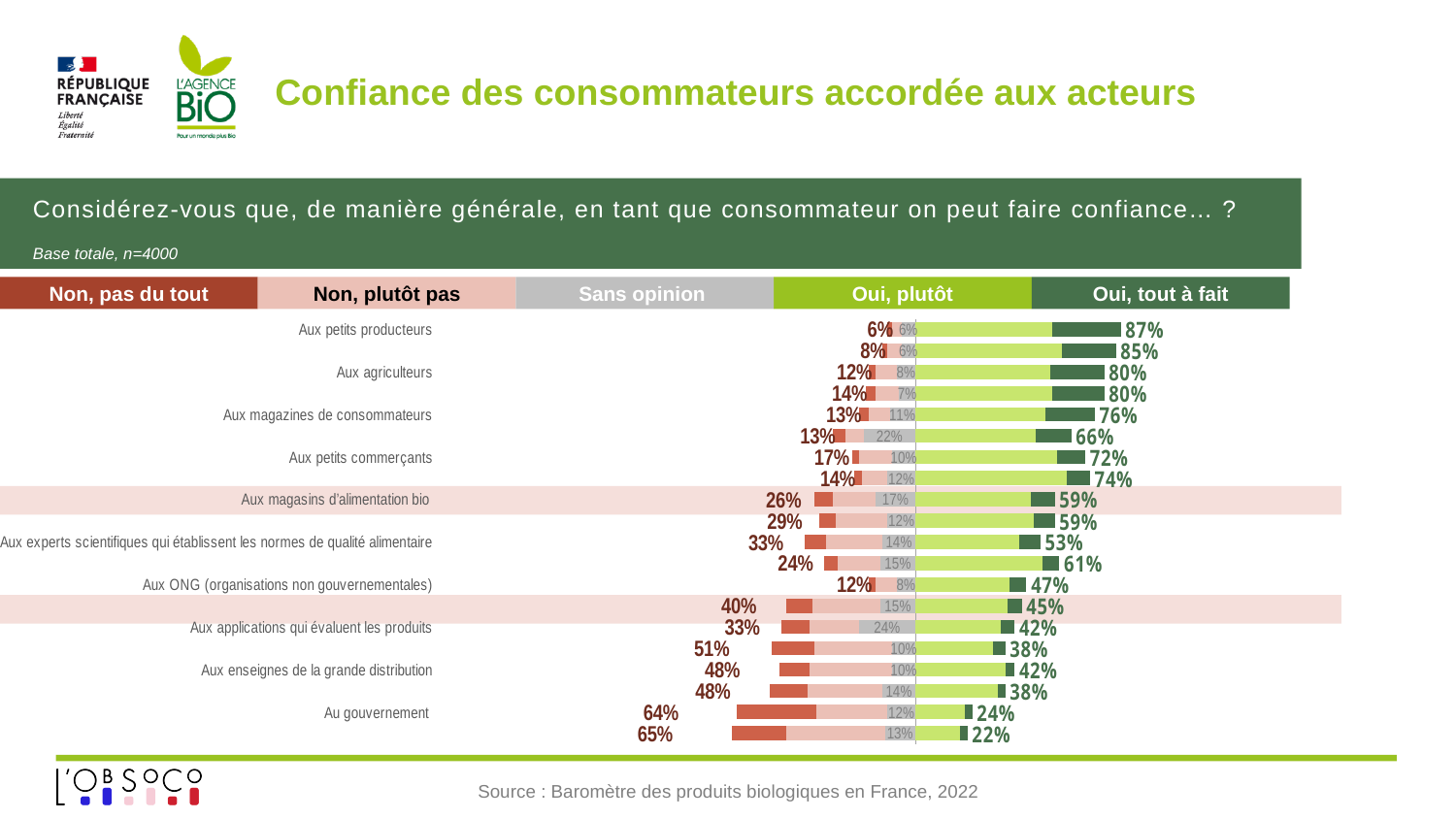
How many response categories does the legend list? 5 What is the 'Non' value shown on the upper bar for 'Au gouvernement'? 64% Which has a larger 'Oui, tout à fait' value: 'Aux agriculteurs' or 'Au gouvernement'? Aux agriculteurs Which actor has the highest 'Oui, tout à fait' value? Aux petits producteurs What kind of chart is shown on the slide? bar chart What is the total base size (n) stated on the slide? n=4000 How many actors (row labels) are listed in the chart? 10